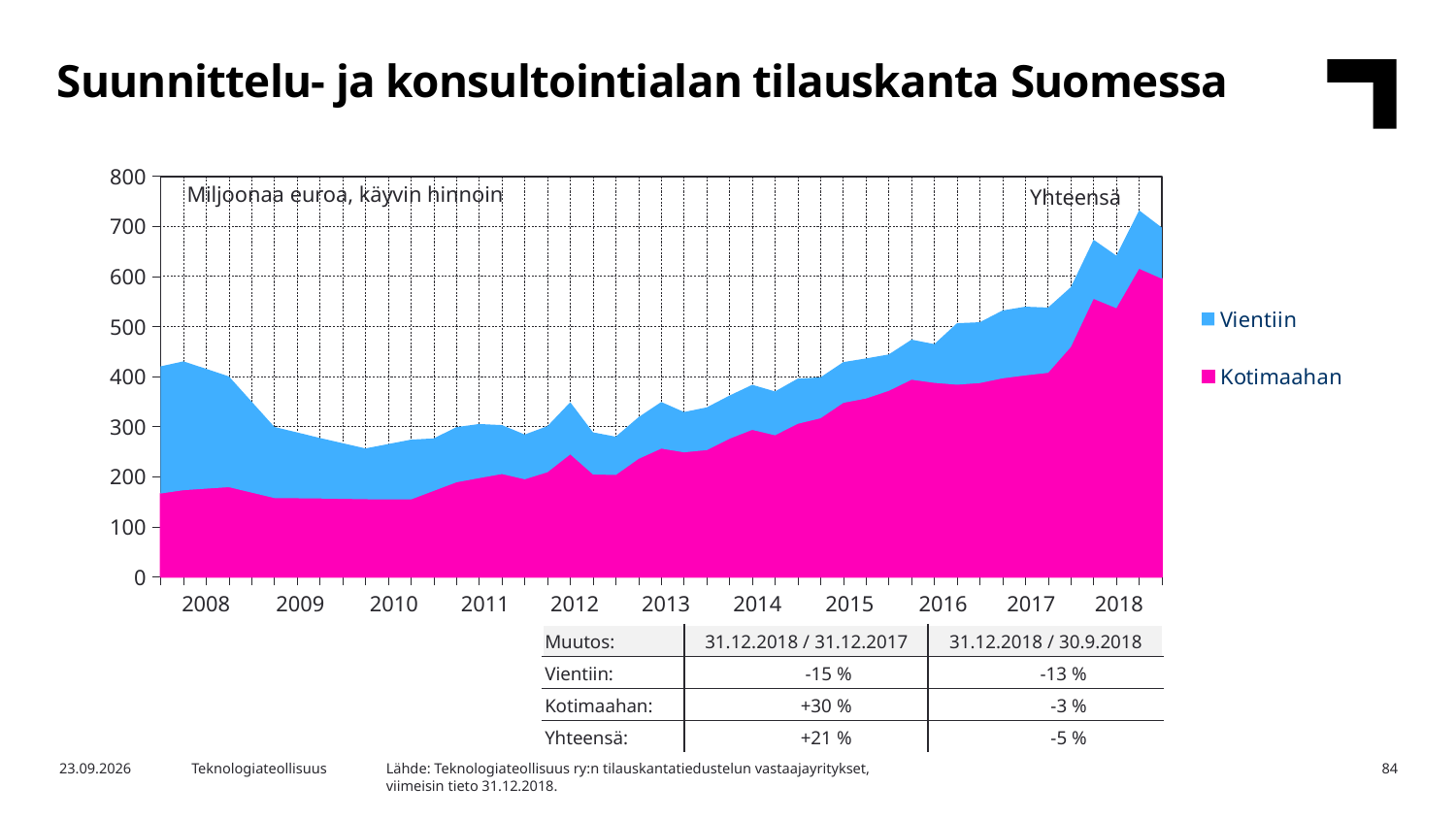
What unit is stated in the text inside the chart area? Miljoonaa euroa, käyvin hinnoin According to the table below the chart, what is the change in Vientiin for 31.12.2018 / 31.12.2017? -15 % According to the table below the chart, what is the change in Yhteensä for 31.12.2018 / 30.9.2018? -5 % Does the Kotimaahan series generally rise or fall from 2010 to 2018? rise How many series does the chart legend list? 2 Is the total (Yhteensä) value at the start of 2010 greater or less than 300? less Is the Kotimaahan value at the start of 2008 greater or less than 200? less Is the total (Yhteensä) value at the start of 2008 greater or less than 400? greater How many year labels are shown on the x axis? 11 What kind of chart is shown on the slide? Stacked area chart Which two series are listed in the chart legend? Vientiin and Kotimaahan